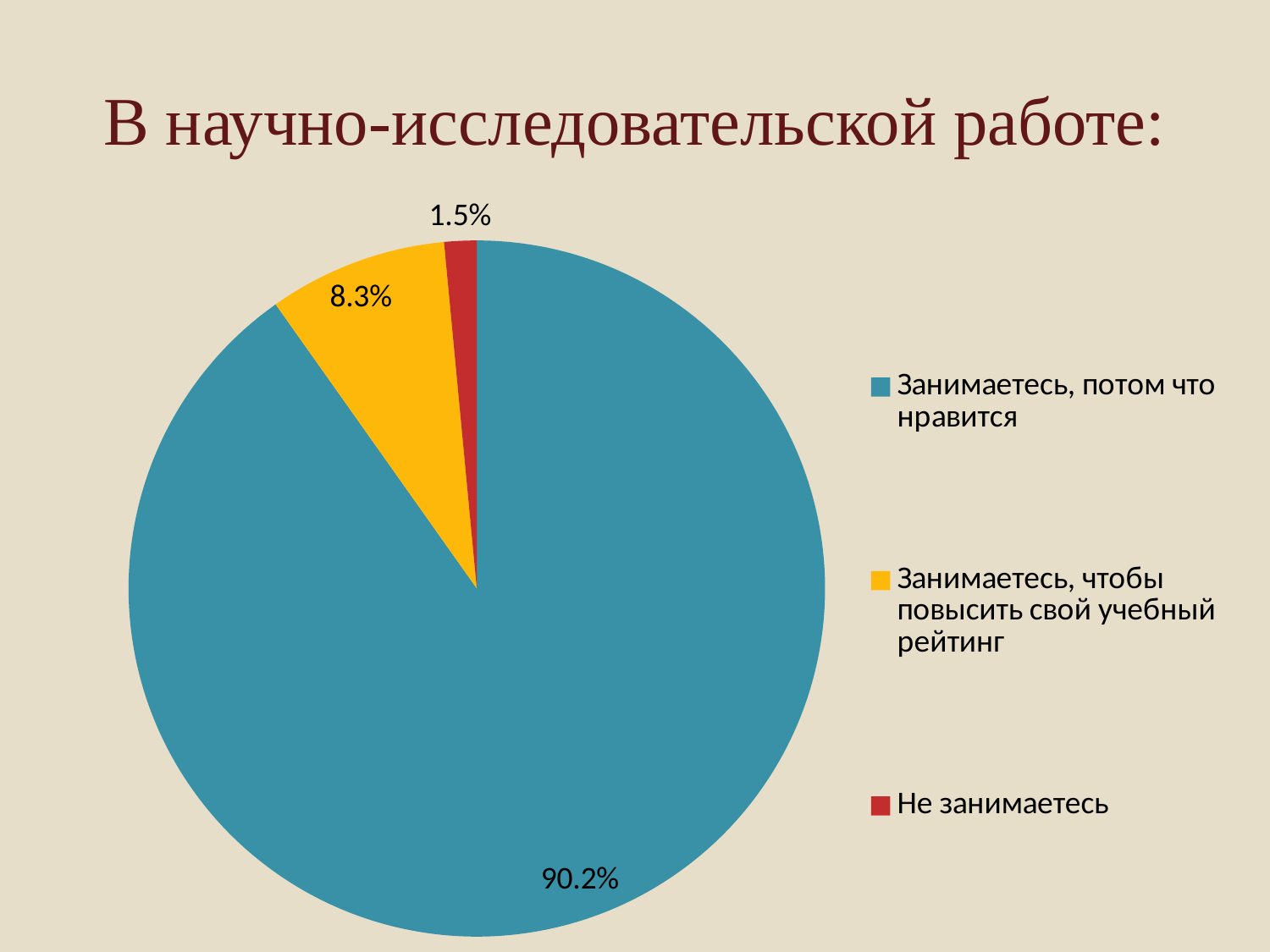
What share of the pie is labelled "Не занимаетесь"? 1.5% What share of the pie is labelled "Занимаетесь, чтобы повысить свой учебный рейтинг"? 8.3% What share of the pie is labelled "Занимаетесь, потом что нравится"? 90.2% Which category has the smallest slice of the pie? Не занимаетесь Which is larger: the share for "Занимаетесь, чтобы повысить свой учебный рейтинг" or the share for "Не занимаетесь"? Занимаетесь, чтобы повысить свой учебный рейтинг What is the title of the slide above the chart? В научно-исследовательской работе: What is the difference between the shares for "Занимаетесь, чтобы повысить свой учебный рейтинг" and "Не занимаетесь"? 6.8% How many entries does the legend list? 3 How many slices does the pie chart have? 3 What colour is the slice for "Не занимаетесь"? red Which category has the largest slice of the pie? Занимаетесь, потом что нравится What kind of chart is shown on the slide? pie chart